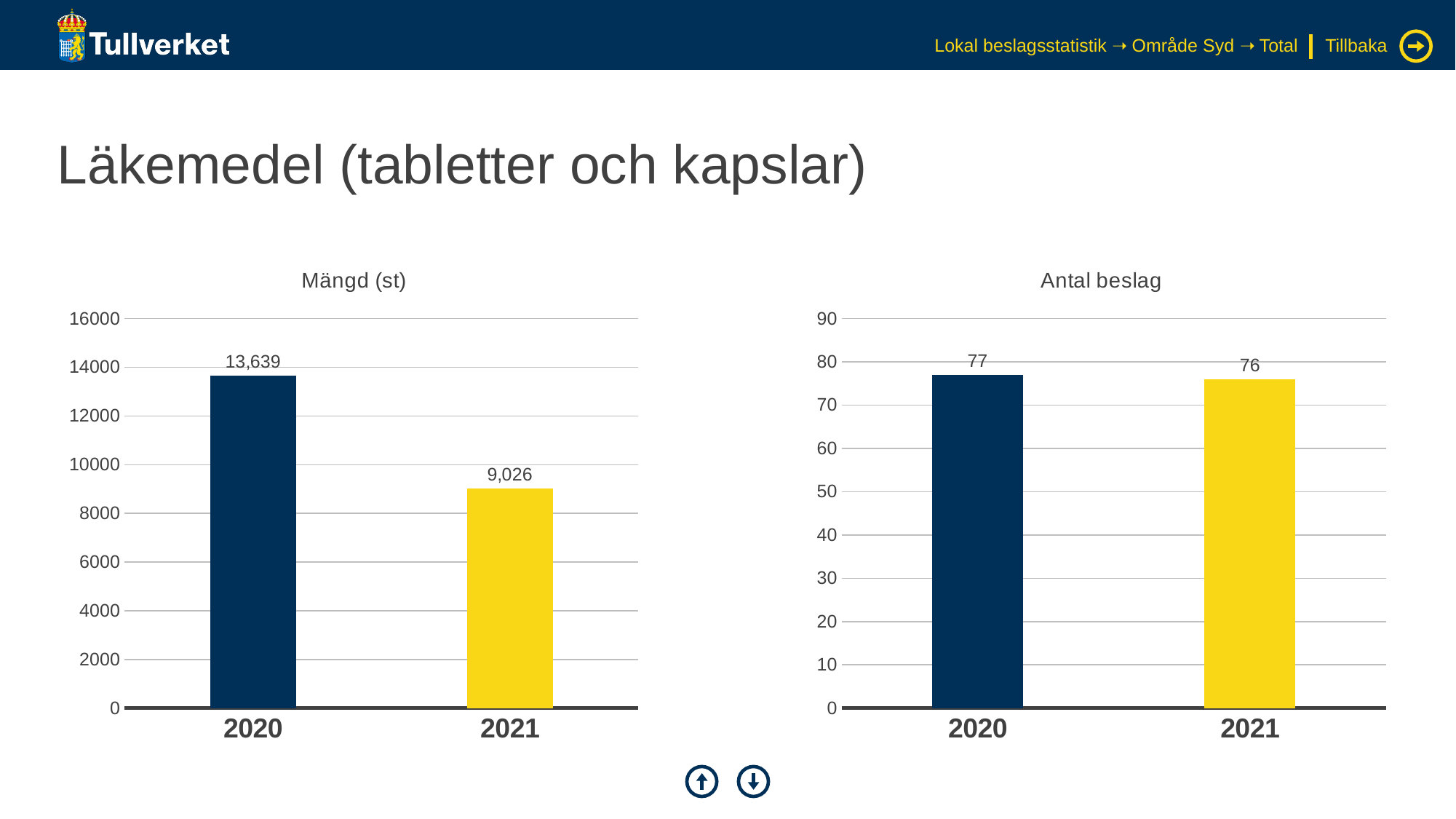
In the 'Antal beslag' chart, what is the value for 2021? 76 In the 'Mängd (st)' chart, what is the value for 2021? 9,026 In the 'Antal beslag' chart, is the value for 2020 greater or less than 70? greater In the 'Mängd (st)' chart, what is the difference between the 2020 and 2021 values? 4,613 In the 'Mängd (st)' chart, which year has the highest value? 2020 What kind of chart is the 'Mängd (st)' chart? bar chart How many categories are shown in the 'Antal beslag' chart? 2 In the 'Antal beslag' chart, what is the value for 2020? 77 In the 'Mängd (st)' chart, do the values rise or fall from 2020 to 2021? fall In the 'Antal beslag' chart, what is the difference between the 2020 and 2021 values? 1 In the 'Mängd (st)' chart, is the value for 2021 greater or less than 10000? less In the 'Mängd (st)' chart, what is the value for 2020? 13,639